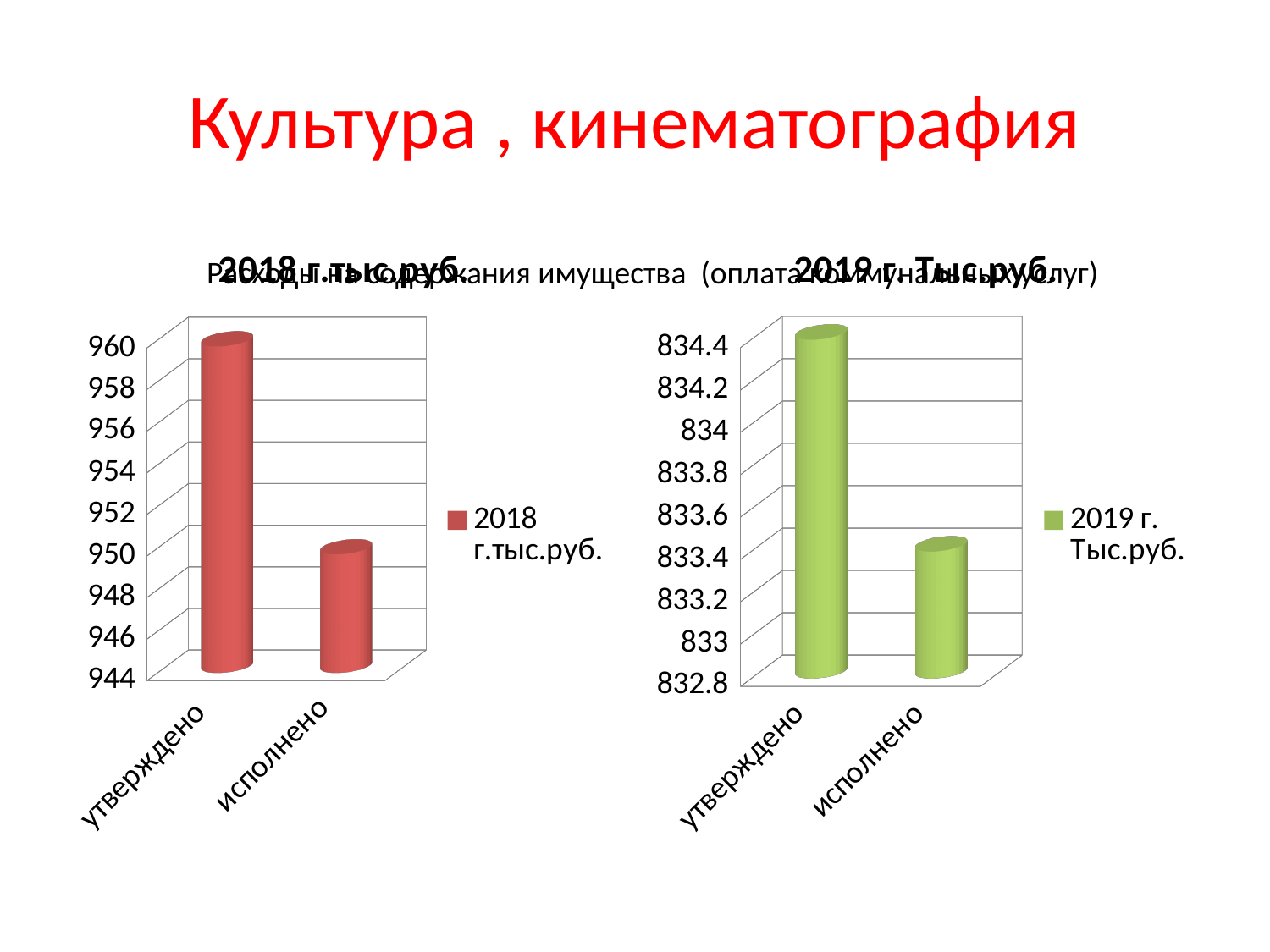
On the right chart, is the value for исполнено greater or less than 834? less What colour are the bars on the left chart? red How many series does the legend of the right chart list? 1 On the left chart, is the value for исполнено greater or less than 952? less On the left chart, is the value for утверждено greater or less than 956? greater On the right chart, do the values rise or fall from утверждено to исполнено? fall On the left chart, which category has the higher value, утверждено or исполнено? утверждено On the right chart, which category has the lowest value? исполнено What is the legend entry of the right chart? 2019 г. Тыс.руб. How many categories are shown on the left chart? 2 What kind of chart is the left chart? bar chart